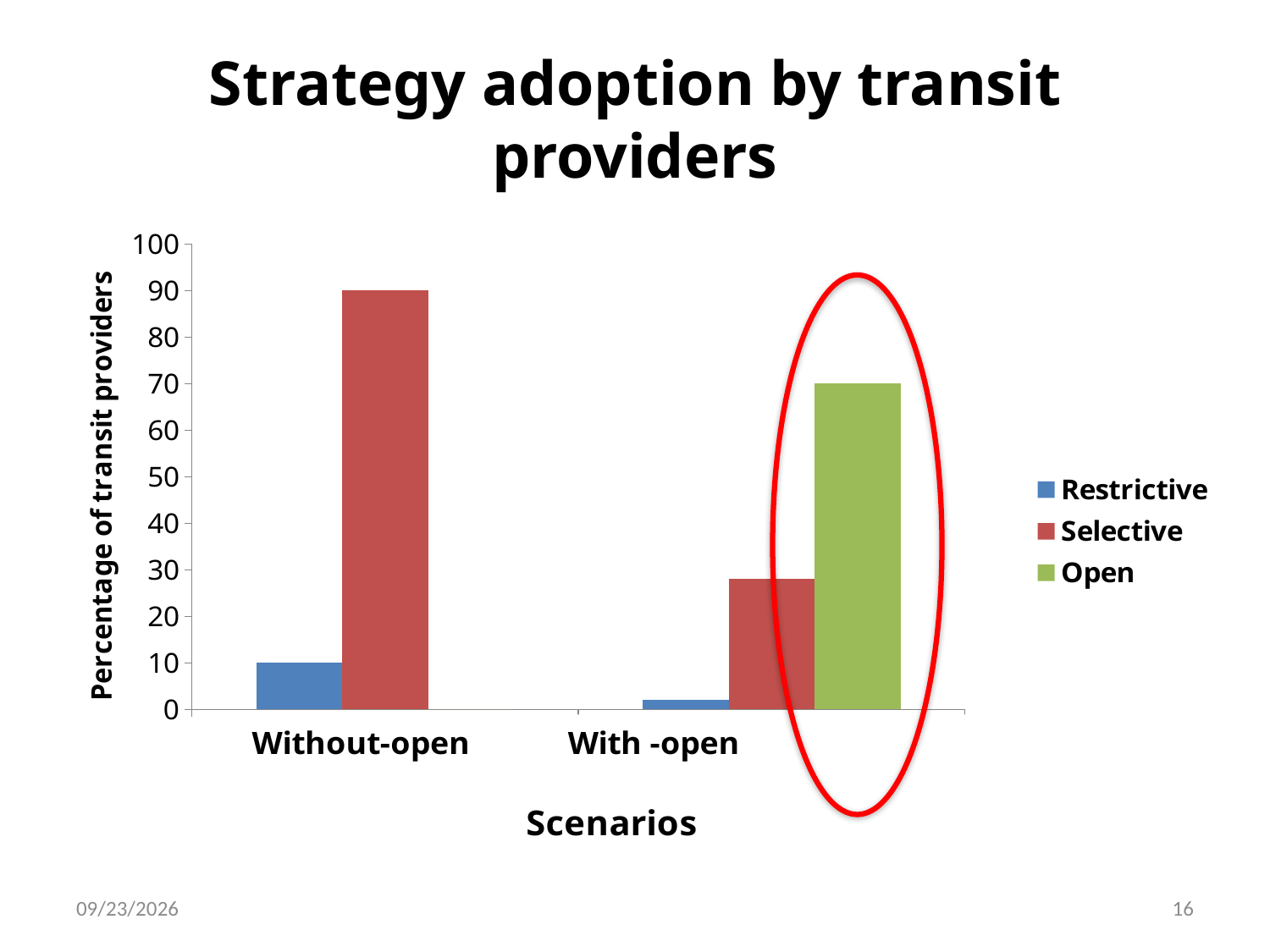
How many scenario categories are shown on the x axis? 2 Which strategy has the highest percentage in the With -open scenario? Open Which strategy has the lowest percentage in the With -open scenario? Restrictive Which series is highlighted with a red ellipse on the chart? Open Is the value for Restrictive in the With -open scenario greater or less than 10? less What is the percentage of transit providers for Restrictive in the Without-open scenario? 10 Is the value for Selective in the With -open scenario greater or less than 30? less What type of chart is shown on the slide? Bar chart What is the percentage of transit providers for Selective in the Without-open scenario? 90 How many series does the legend list? 3 What is the difference between the Selective and Restrictive values in the Without-open scenario? 80 What is the percentage of transit providers for Open in the With -open scenario? 70